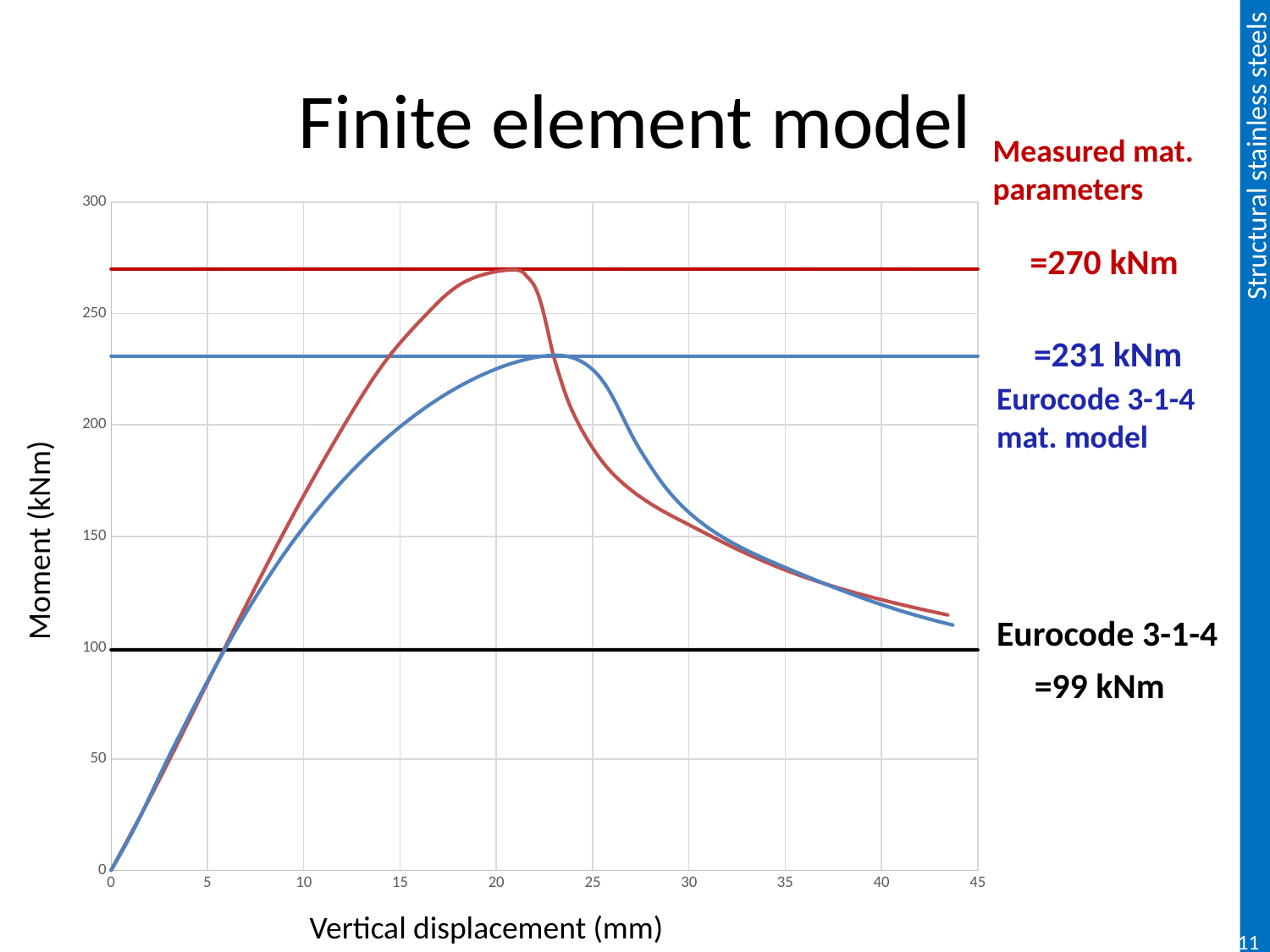
What kind of chart is shown on the slide? line chart What is the peak moment reached by the finite element model with the Eurocode 3-1-4 material model? 231 kNm What is the label of the y axis? Moment (kNm) Does the moment for the measured material parameters curve rise or fall as vertical displacement increases from 0 mm to 20 mm? rise What is the difference between the Eurocode 3-1-4 material model peak (231 kNm) and the Eurocode 3-1-4 value of 99 kNm? 132 kNm What is the label of the x axis? Vertical displacement (mm) What is the peak moment reached by the finite element model with measured material parameters? 270 kNm At a vertical displacement of 15 mm, is the moment for the measured material parameters curve greater or less than 200 kNm? greater What is the difference between the peak moment with measured material parameters (270 kNm) and with the Eurocode 3-1-4 material model (231 kNm)? 39 kNm What moment value is given for Eurocode 3-1-4 (the black horizontal line)? 99 kNm Which curve reaches a higher peak moment: the measured material parameters curve or the Eurocode 3-1-4 material model curve? measured material parameters At a vertical displacement of 40 mm, is the moment for the Eurocode 3-1-4 material model curve greater or less than 150 kNm? less